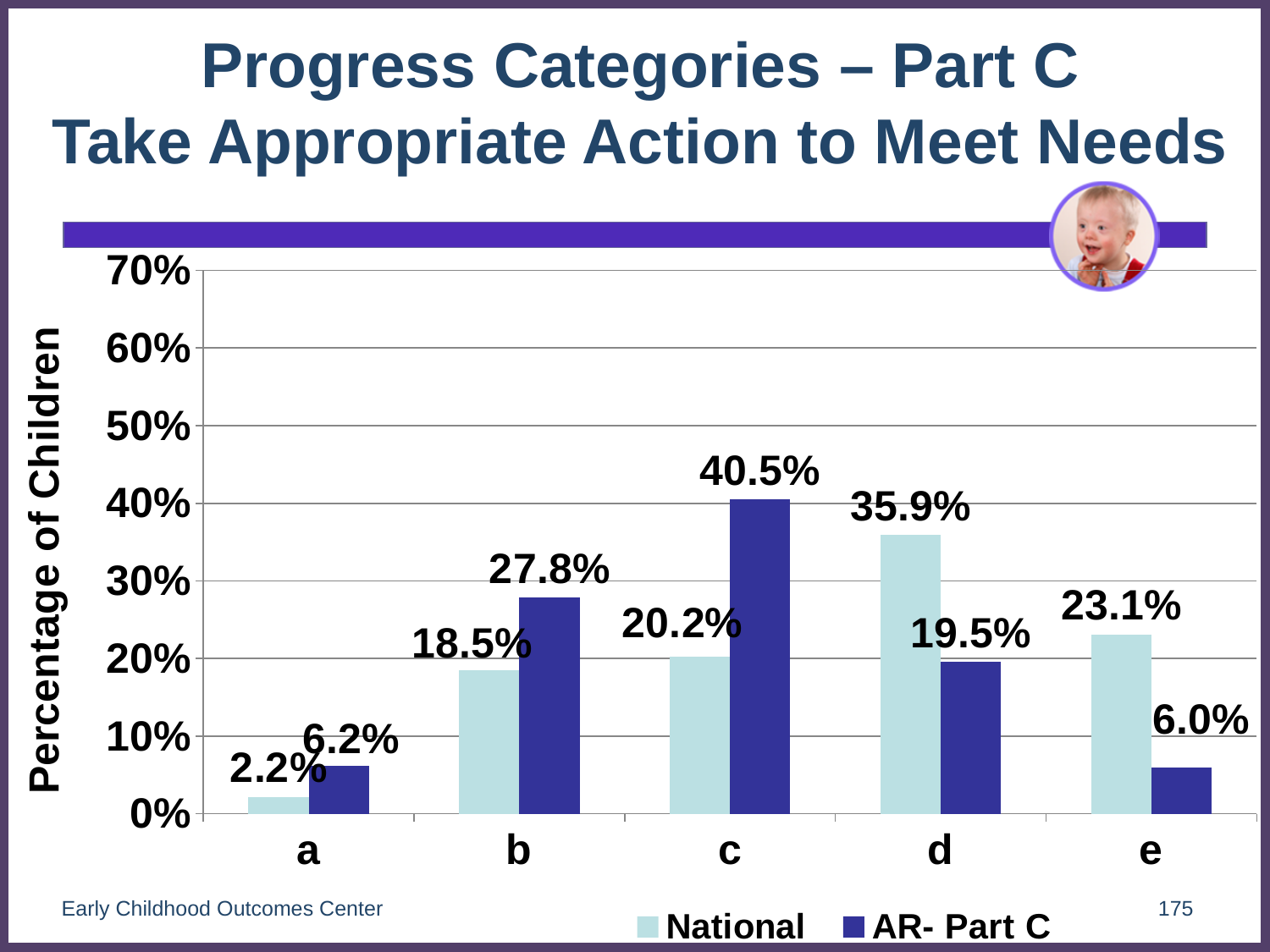
What is the AR- Part C value for category b? 27.8% For category d, which series has the larger value, National or AR- Part C? National Which category has the lowest National value? a What is the label of the y axis? Percentage of Children What is the National value for category e? 23.1% Which category has the highest AR- Part C value? c How many categories are shown on the x axis? 5 Is the AR- Part C value for category c greater or less than 40%? greater What is the difference between the AR- Part C and National values for category c? 20.3% How many series does the legend list? 2 What is the National value for category c? 20.2% What kind of chart is shown on the slide? bar chart